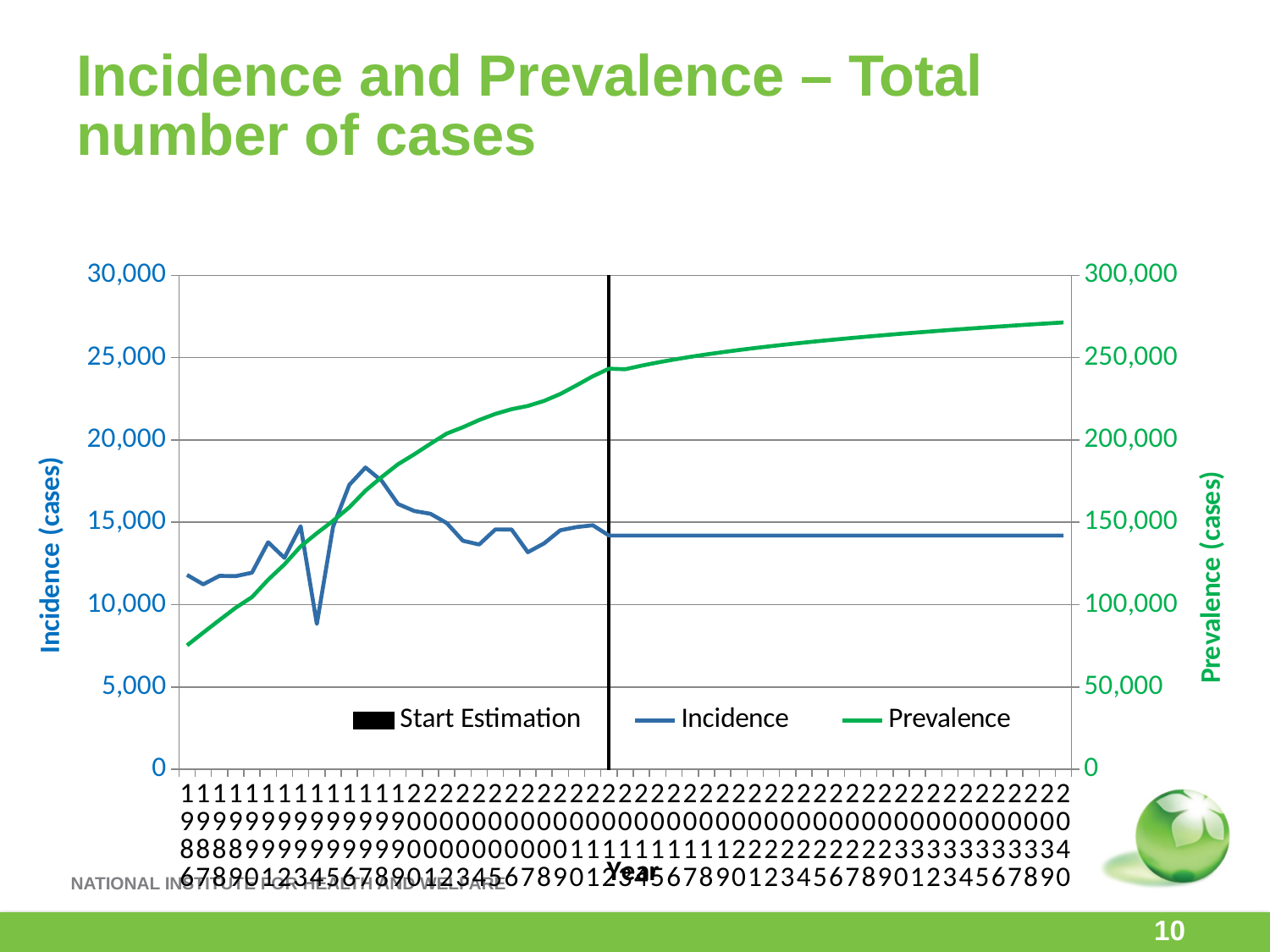
How many entries does the chart legend list? 3 Is the Incidence value at the first year on the chart greater or less than 10,000? greater Is the flat Incidence value after the Start Estimation line greater or less than 15,000? less Is the Prevalence value at the last year on the chart greater or less than 250,000? greater What is the label of the right-hand vertical axis? Prevalence (cases) Does the Prevalence line rise or fall overall along the x axis? rise What kind of chart is shown on the slide? combination bar and line chart What is the title of the slide? Incidence and Prevalence – Total number of cases